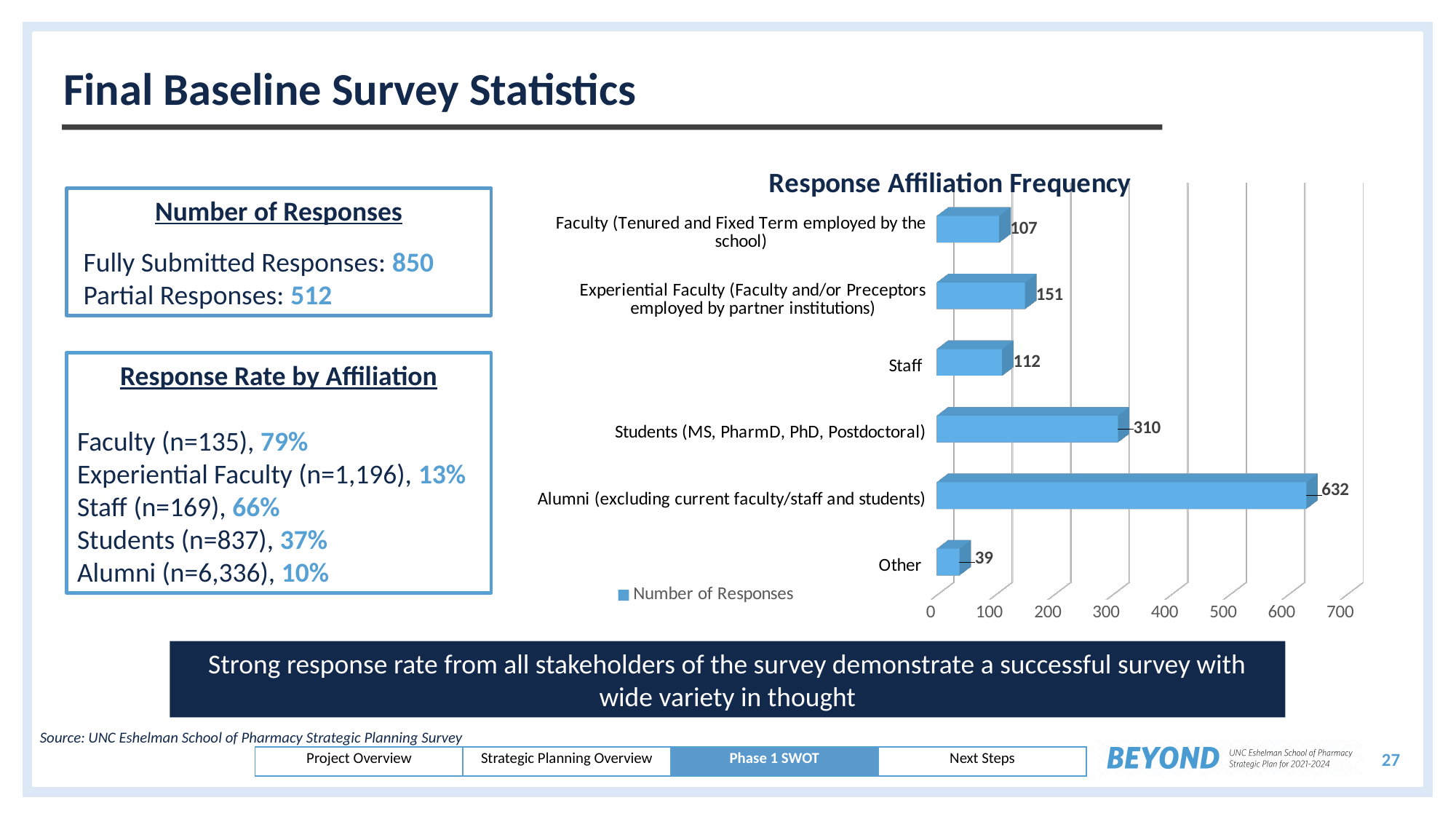
How many series does the legend list? 1 Which category has the lowest number of responses? Other What is the title of the chart? Response Affiliation Frequency How many categories are plotted in the chart? 6 What is the number of responses for Experiential Faculty (Faculty and/or Preceptors employed by partner institutions)? 151 What is the number of responses for Staff? 112 Which category has the highest number of responses? Alumni (excluding current faculty/staff and students) What is the number of responses for Alumni (excluding current faculty/staff and students)? 632 Which has more responses, Staff or Faculty (Tenured and Fixed Term employed by the school)? Staff What is the difference in number of responses between Alumni and Students (MS, PharmD, PhD, Postdoctoral)? 322 What is the legend entry for the series in the chart? Number of Responses What type of chart is shown on the slide? bar chart